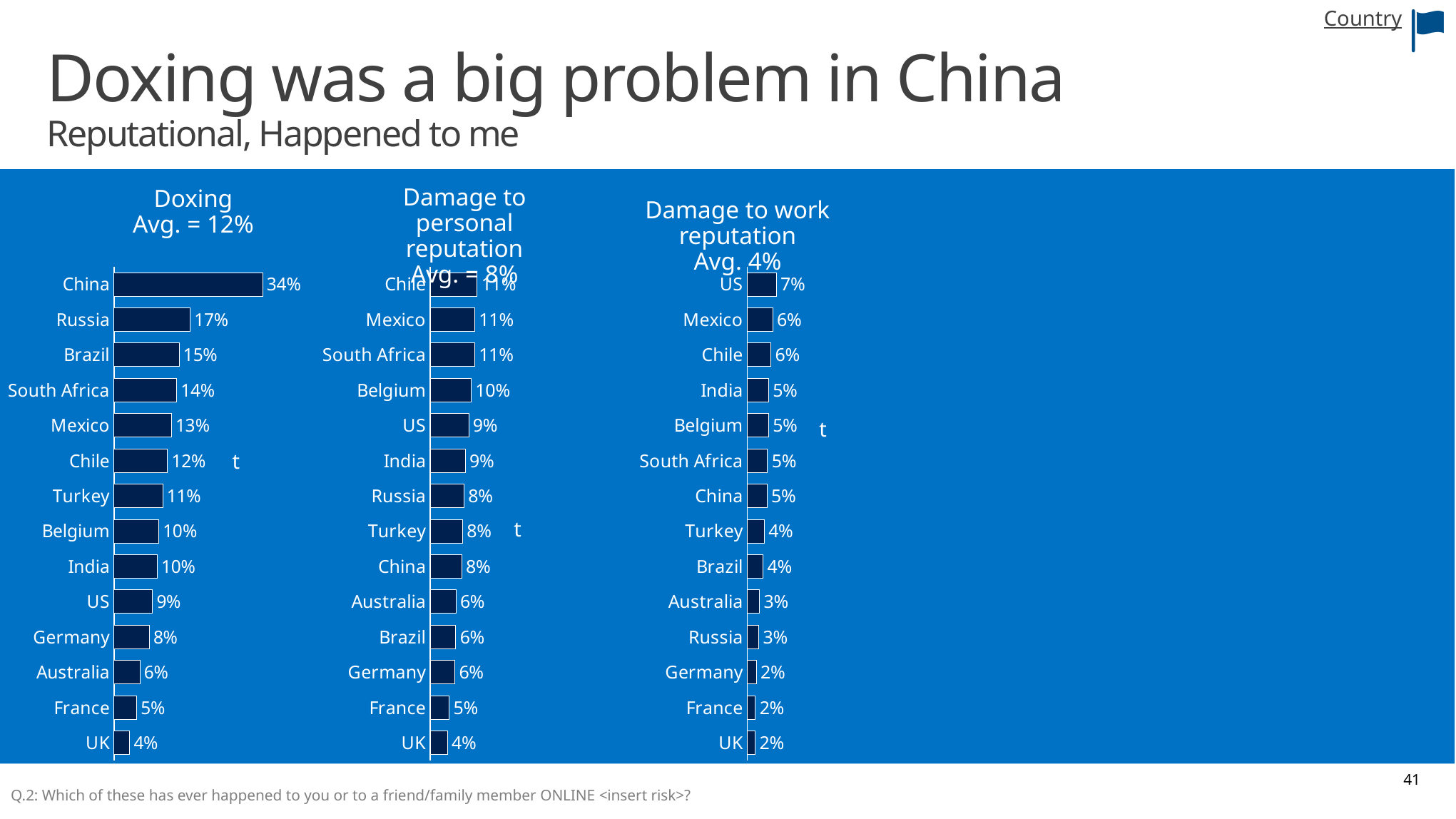
In the Damage to personal reputation chart, which country has the lowest value? UK In the Doxing chart, which country has the lowest value? UK In the Doxing chart, what is the value for China? 34% What average is shown in the title of the Doxing chart? 12% In the Doxing chart, what is the difference between China and Russia? 17% In the Damage to personal reputation chart, what is the value for Belgium? 10% In the Damage to work reputation chart, what is the value for China? 5% In the Doxing chart, what is the difference between Brazil and Mexico? 2% In the Damage to work reputation chart, which country has the highest value? US What type of chart is the Doxing chart? Bar chart In the Damage to work reputation chart, is the value for Turkey or Australia larger? Turkey How many countries are shown in the Doxing chart? 14